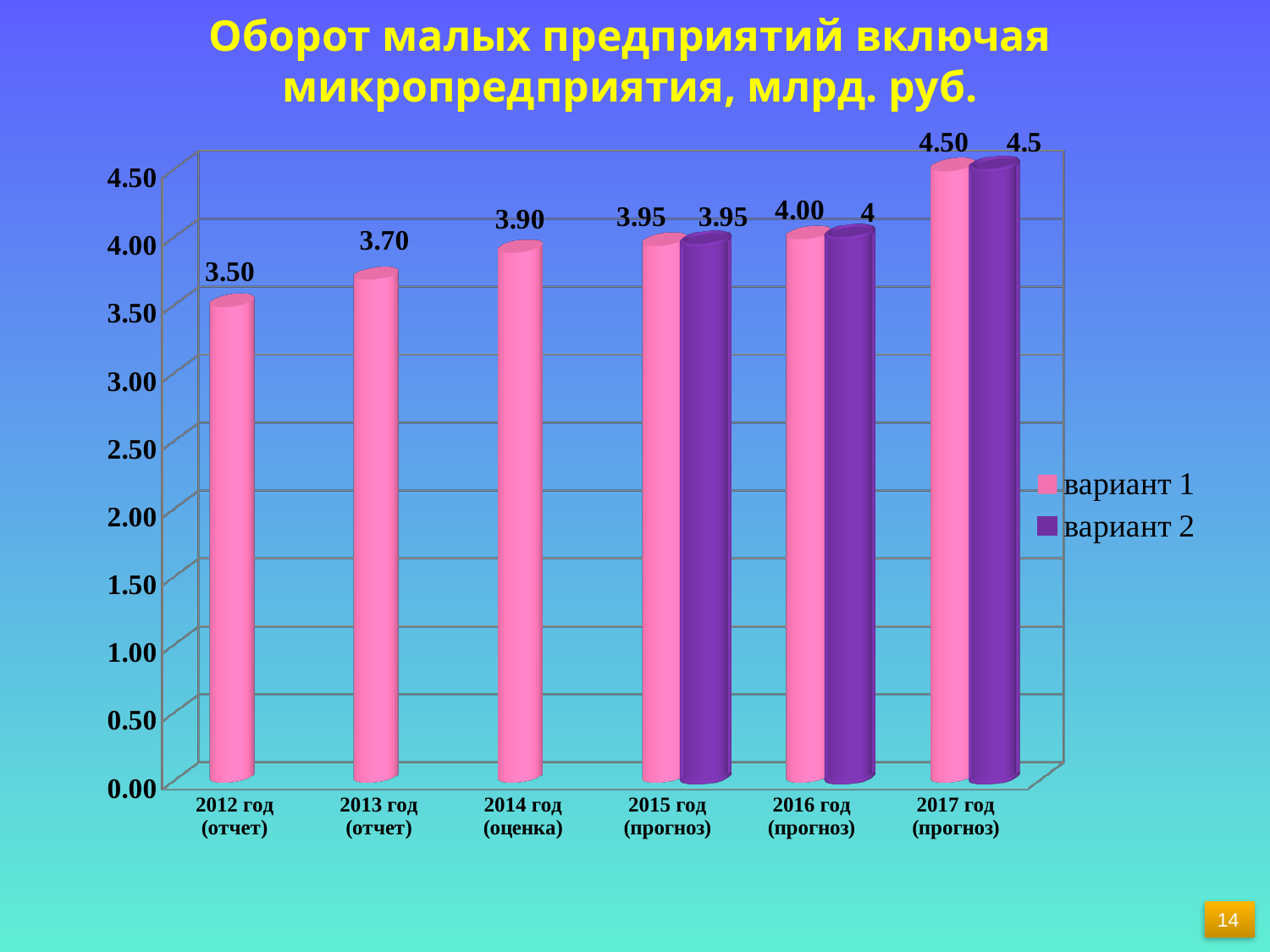
How many year categories are shown on the x axis? 6 Do the вариант 1 values rise or fall from 2012 to 2017? rise What is the difference between the вариант 1 values for 2017 год (прогноз) and 2012 год (отчет)? 1.00 How many series does the legend list? 2 What is the value for вариант 1 in 2012 год (отчет)? 3.50 What is the value for вариант 1 in 2014 год (оценка)? 3.90 Which is larger: the вариант 1 value for 2013 год (отчет) or for 2014 год (оценка)? 2014 год (оценка) Which year has the lowest value for вариант 1? 2012 год (отчет) Which year has the highest value for вариант 1? 2017 год (прогноз) What is the value for вариант 2 in 2016 год (прогноз)? 4 What is the value for вариант 2 in 2017 год (прогноз)? 4.5 What kind of chart is shown on the slide? bar chart